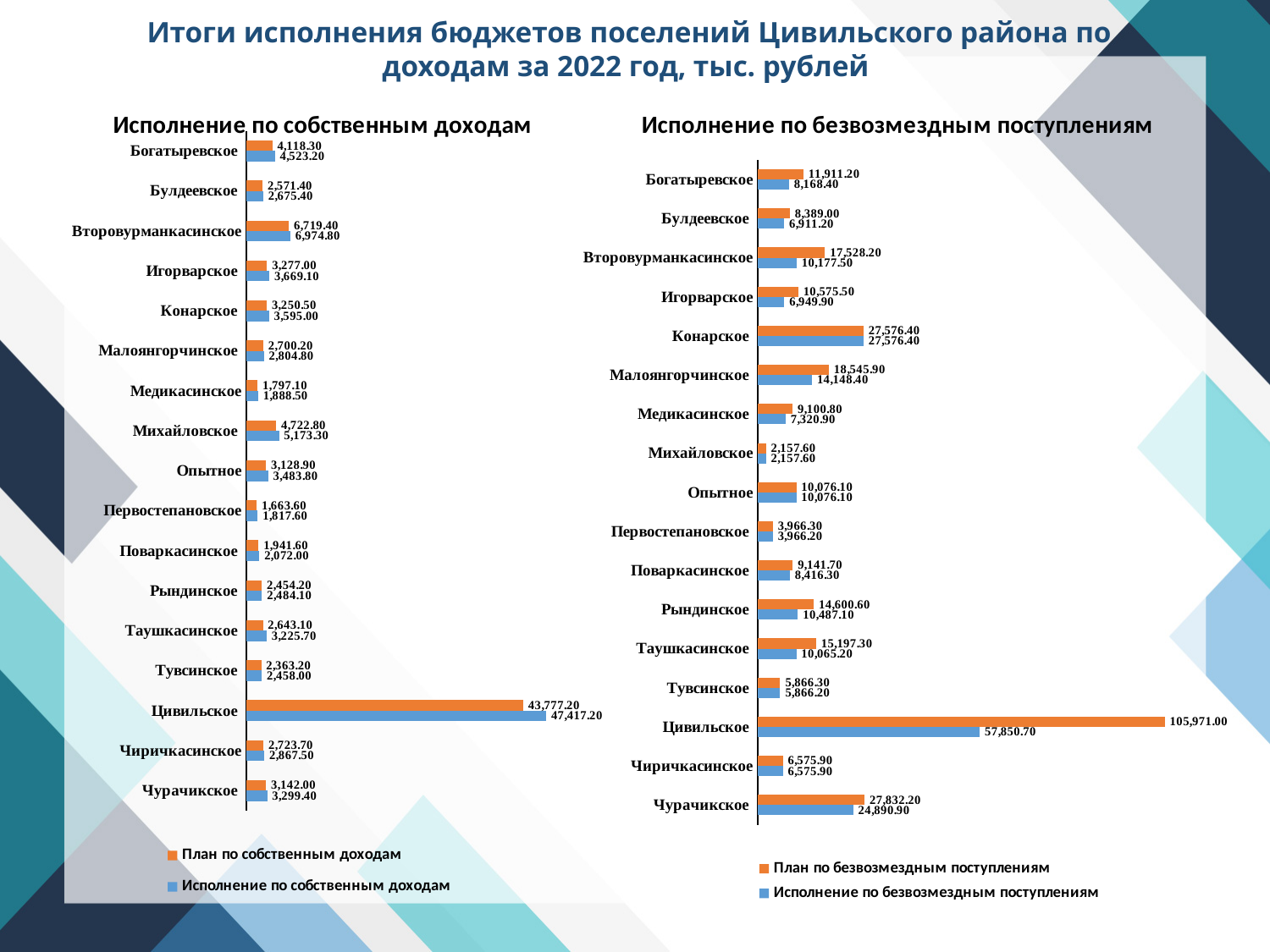
On the chart titled "Исполнение по безвозмездным поступлениям", what is the value of "Исполнение по безвозмездным поступлениям" for Малоянгорчинское? 14,148.40 On the chart titled "Исполнение по безвозмездным поступлениям", which settlement has the lowest value of "Исполнение по безвозмездным поступлениям"? Михайловское What type of chart is the chart titled "Исполнение по безвозмездным поступлениям"? Bar chart On the chart titled "Исполнение по безвозмездным поступлениям", what is the difference between "План по безвозмездным поступлениям" and "Исполнение по безвозмездным поступлениям" for Цивильское? 48,120.30 On the chart titled "Исполнение по собственным доходам", what is the value of "План по собственным доходам" for Богатыревское? 4,118.30 On the chart titled "Исполнение по собственным доходам", which settlement has the lowest value of "План по собственным доходам"? Первостепановское On the chart titled "Исполнение по собственным доходам", what is the difference between "Исполнение по собственным доходам" and "План по собственным доходам" for Цивильское? 3,640.00 On the chart titled "Исполнение по собственным доходам", which settlement has the highest value of "Исполнение по собственным доходам"? Цивильское On the chart titled "Исполнение по безвозмездным поступлениям", which is larger for Второвурманкасинское: "План по безвозмездным поступлениям" or "Исполнение по безвозмездным поступлениям"? План по безвозмездным поступлениям On the chart titled "Исполнение по безвозмездным поступлениям", what is the value of "План по безвозмездным поступлениям" for Цивильское? 105,971.00 How many settlements are shown on the chart titled "Исполнение по собственным доходам"? 17 On the chart titled "Исполнение по собственным доходам", what is the value of "Исполнение по собственным доходам" for Цивильское? 47,417.20